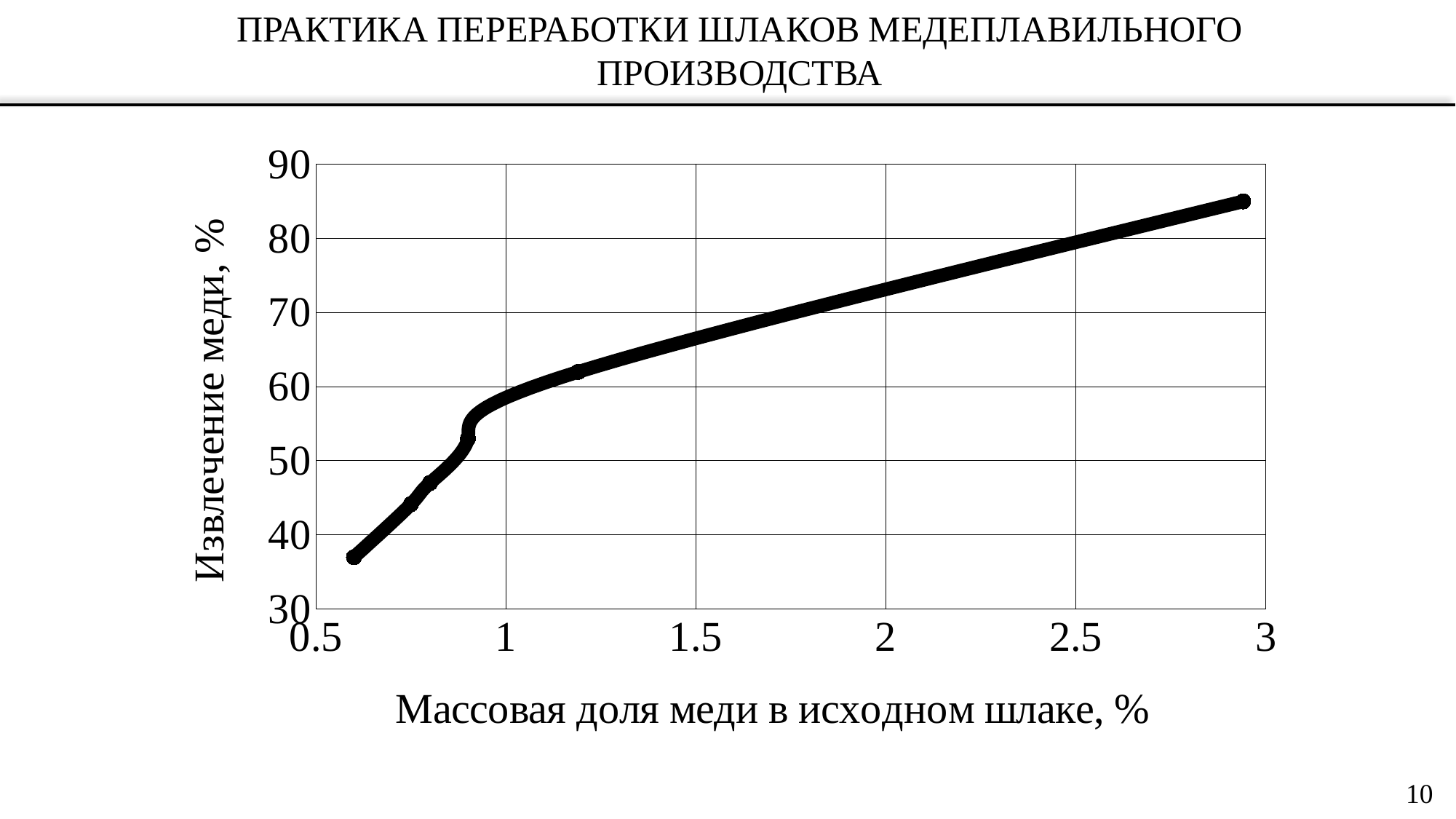
What is the label of the horizontal axis? Массовая доля меди в исходном шлаке, % What is the label of the vertical axis? Извлечение меди, % What kind of chart is shown on the slide? line chart Does copper extraction rise or fall as the mass fraction of copper in the initial slag increases? rise Is the copper extraction at the left-hand start of the curve (near 0.6%) greater or less than 40? less Is the copper extraction at a mass fraction of 2.5% greater or less than 70? greater Is the copper extraction at a mass fraction of 2% greater or less than 70? greater